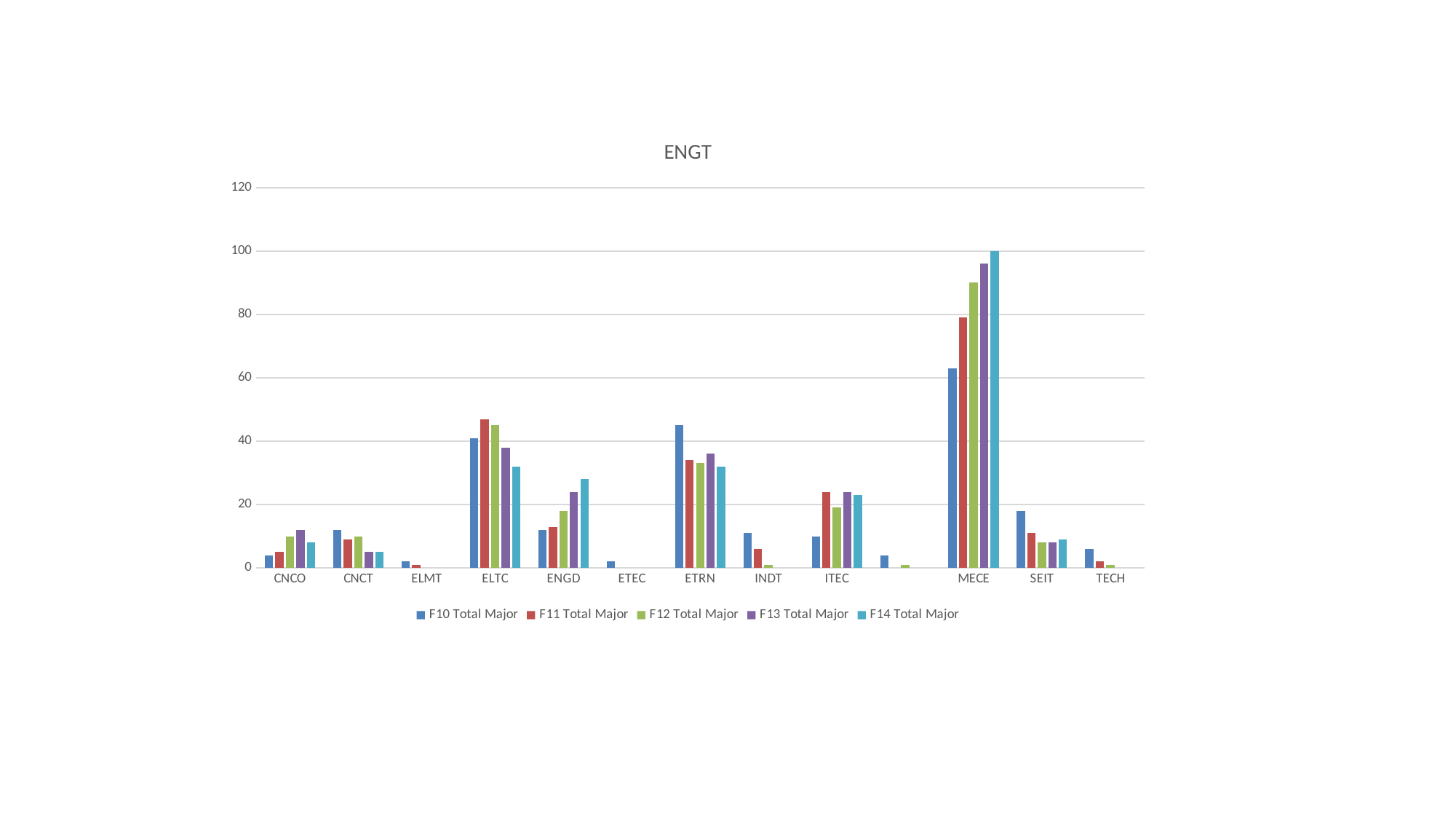
Is the F11 Total Major value for MECE greater or less than 60? greater Do the MECE values rise or fall from F10 Total Major to F14 Total Major? rise What kind of chart is shown on the slide? bar chart What is the title of the chart? ENGT Is the F11 Total Major value for ELTC greater or less than 40? greater How many series does the legend list? 5 Within the ELTC category, which series has the lowest value? F14 Total Major Which is larger, the F11 Total Major value for ELTC or for ETRN? ELTC Which category has the highest F14 Total Major value? MECE Within the MECE category, which series has the highest value? F14 Total Major Is the F10 Total Major value for SEIT greater or less than 20? less